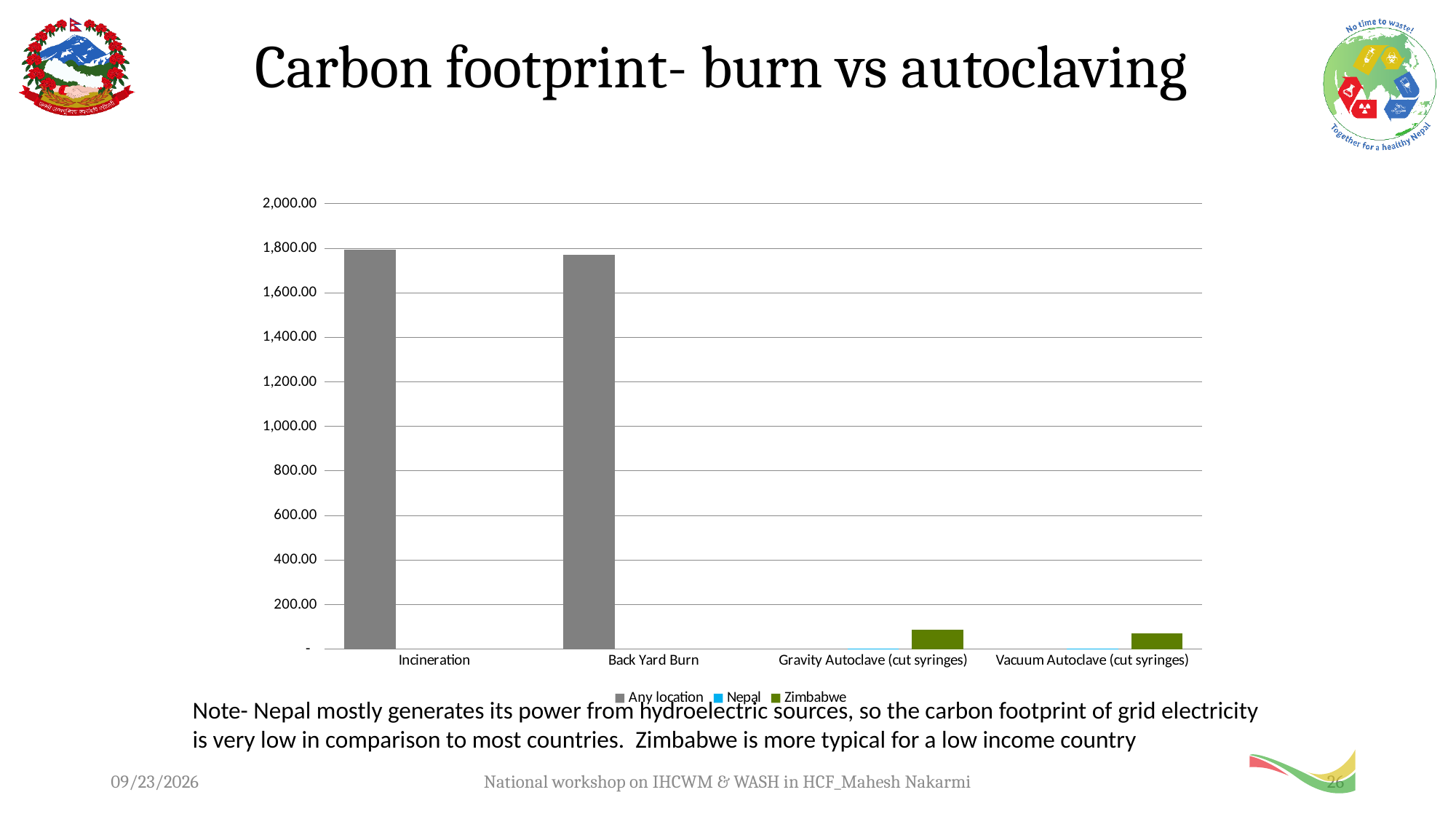
Do the bar values generally rise or fall moving from left to right along the x axis? fall Which series in the legend is shown in green? Zimbabwe Is the value for Vacuum Autoclave (cut syringes) greater or less than 200.00? less Is the value for Gravity Autoclave (cut syringes) greater or less than 200.00? less Is the value for Back Yard Burn greater or less than 1,000.00? greater Which is larger, the value for Back Yard Burn or the value for Vacuum Autoclave (cut syringes)? Back Yard Burn How many series does the chart's legend list? 3 How many categories are shown on the x axis of the chart? 4 Which series do the bars for Incineration and Back Yard Burn belong to? Any location What kind of chart is shown on the slide? bar chart Which is larger, the value for Incineration or the value for Gravity Autoclave (cut syringes)? Incineration